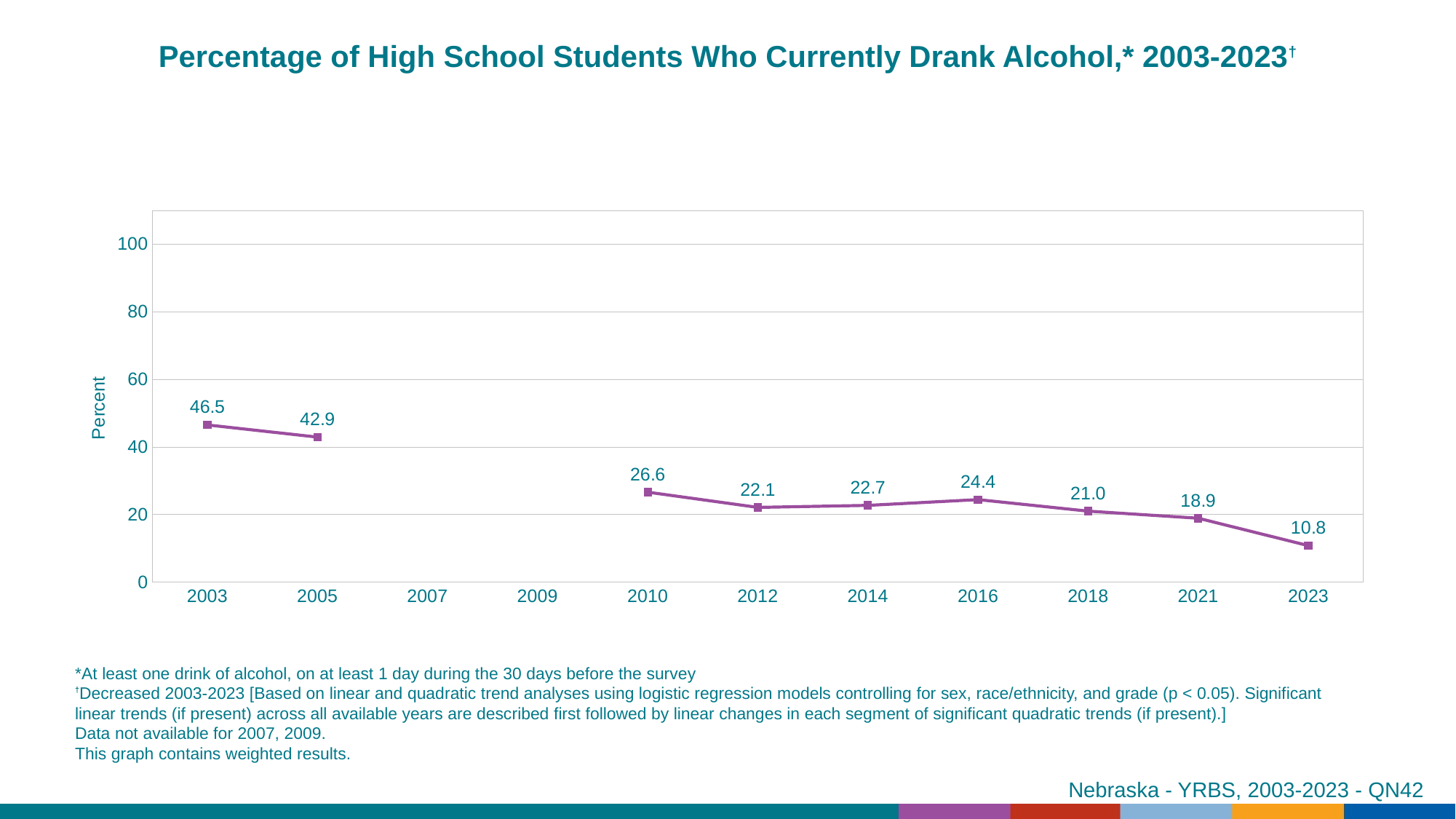
Do the values generally rise or fall from 2003 to 2023? fall What is the difference between the 2010 value and the 2012 value? 4.5 What is the difference between the 2003 value and the 2023 value? 35.7 How many data points are plotted on the chart? 9 What kind of chart is shown on the slide? line chart Which year has a larger value, 2005 or 2010? 2005 What percentage of high school students currently drank alcohol in 2003? 46.5 What is the value plotted for 2023? 10.8 Which year has the lowest percentage? 2023 Which year has the highest percentage? 2003 What is the value plotted for 2016? 24.4 Is the value for 2018 greater or less than 40? less